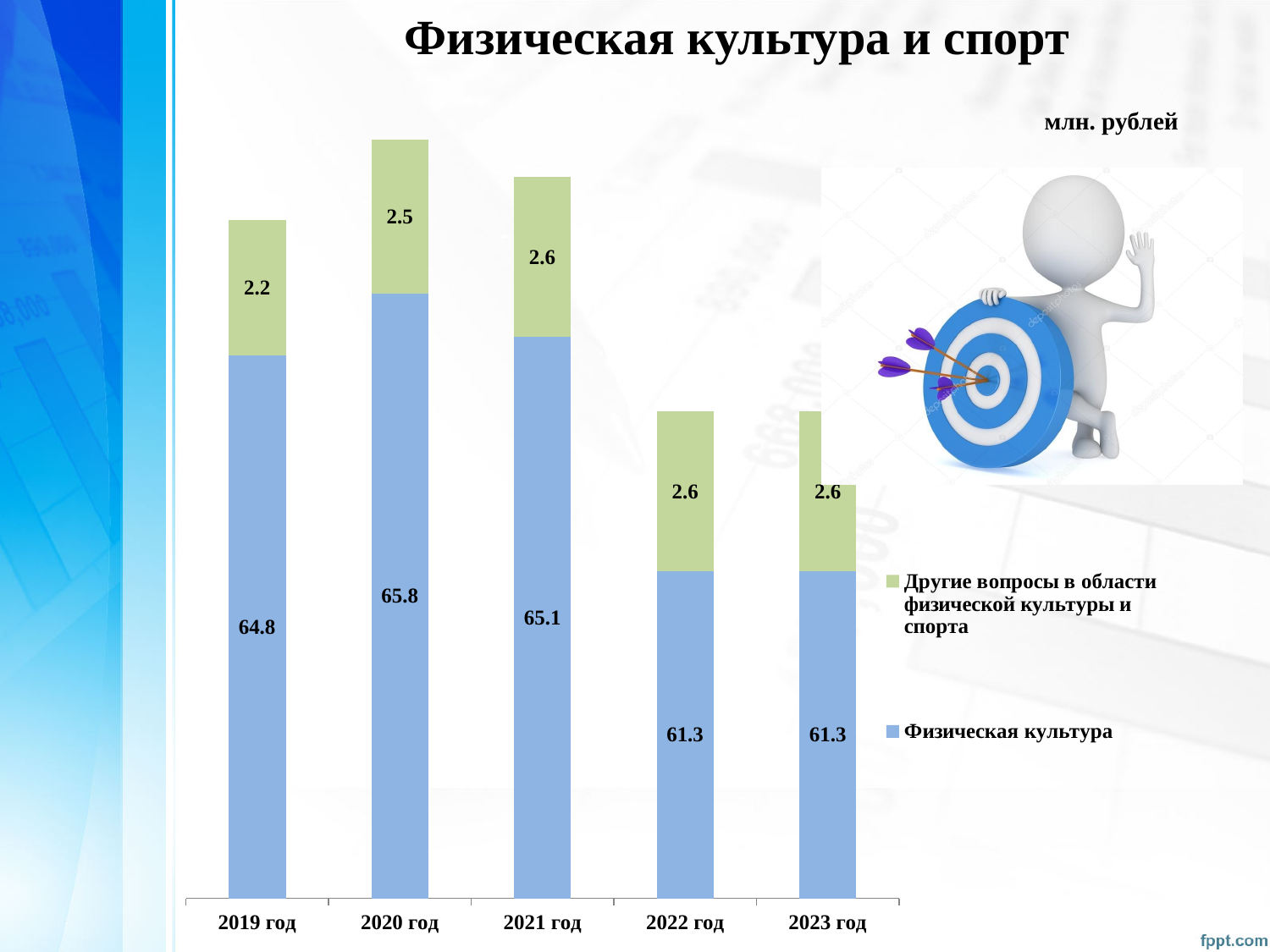
What is the total of the stacked bar for 2020 год? 68.3 What is the value for Другие вопросы в области физической культуры и спорта in 2019 год? 2.2 What is the difference between the Физическая культура values for 2020 год and 2023 год? 4.5 What unit is stated for the values on the chart? млн. рублей What kind of chart is shown on the slide? Stacked bar chart How many years are shown on the x axis? 5 Which year has the highest value for Физическая культура? 2020 год Which is larger, the Физическая культура value for 2019 год or for 2021 год? 2021 год How many series does the legend list? 2 What is the value for Физическая культура in 2022 год? 61.3 What is the value for Физическая культура in 2020 год? 65.8 Which year has the lowest value for Другие вопросы в области физической культуры и спорта? 2019 год